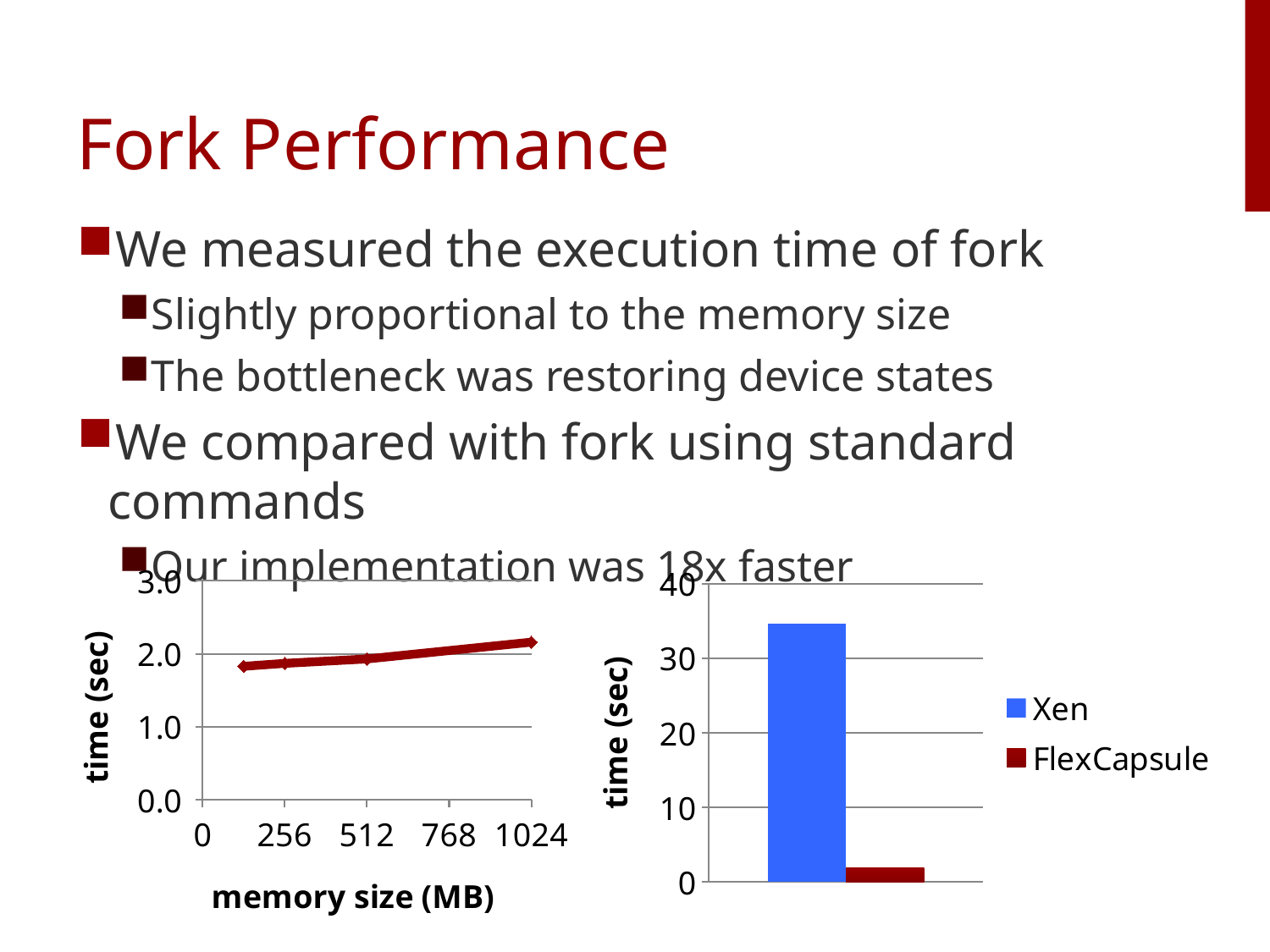
In the left chart, do the values rise or fall as memory size increases? rise In the right chart, is the value for FlexCapsule greater or less than 10? less What is the x-axis label of the left chart? memory size (MB) In the left chart, is the value at 1024 MB greater or less than 2.0? greater What kind of chart is the chart on the right of the slide? bar chart In the left chart, is the value at 1024 MB greater or less than 3.0? less How many data points are plotted in the left chart? 4 In the right chart, which series has the lowest value? FlexCapsule What kind of chart is the chart on the left of the slide? line chart In the right chart, which series has the highest value? Xen How many series does the legend of the right chart list? 2